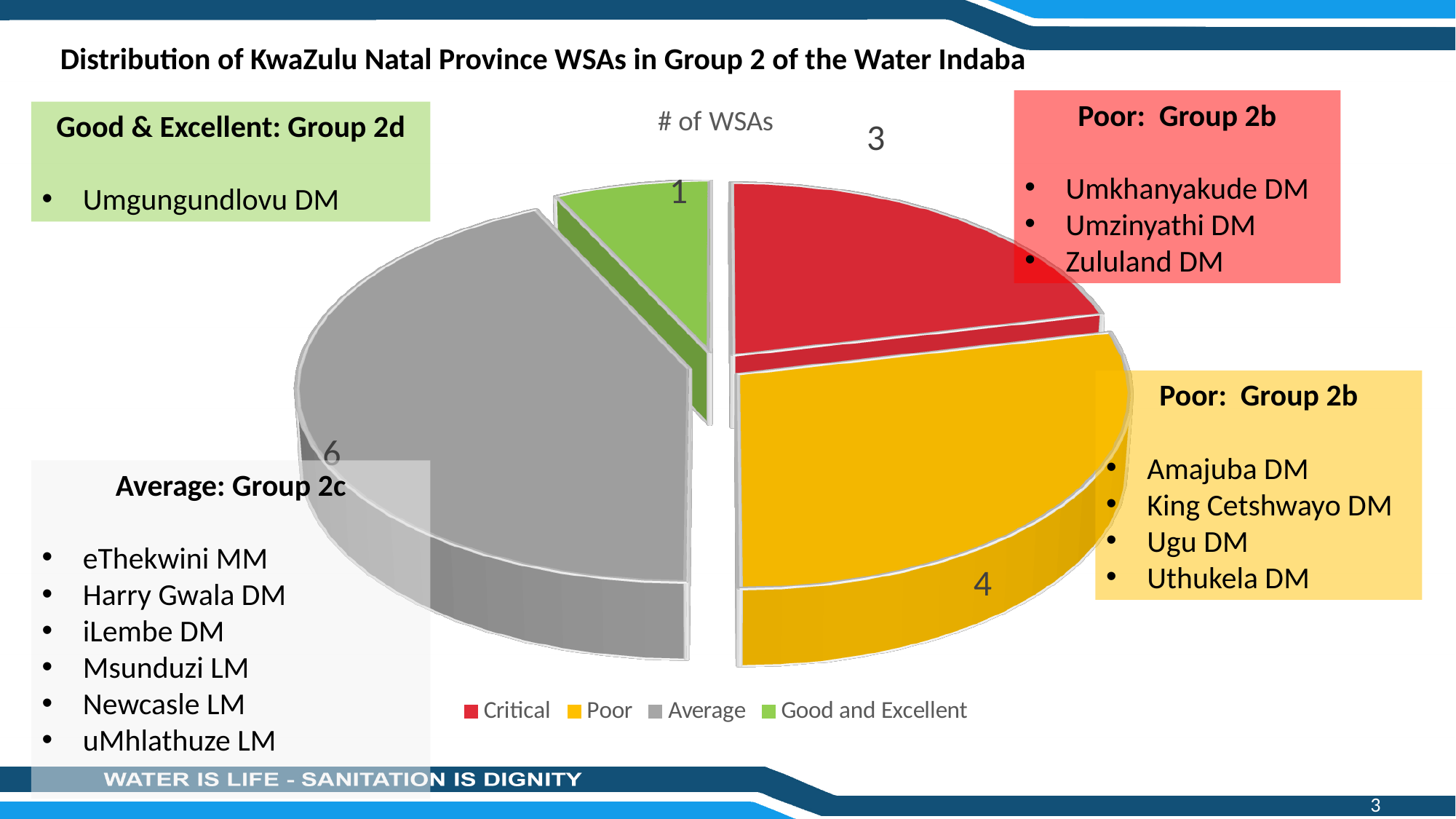
Which category has the largest slice? Average What is the value for the Good and Excellent slice? 1 How many slices does the pie chart have? 4 What is the value for the Critical slice? 3 What is the value for the Poor slice? 4 Which category has the smallest slice? Good and Excellent How many entries does the legend list? 4 What is the difference between the Average and Poor values? 2 What kind of chart is shown on the slide? pie chart What is the value for the Average slice? 6 What is the title of the chart? # of WSAs Which colour represents the Poor category in the legend? yellow